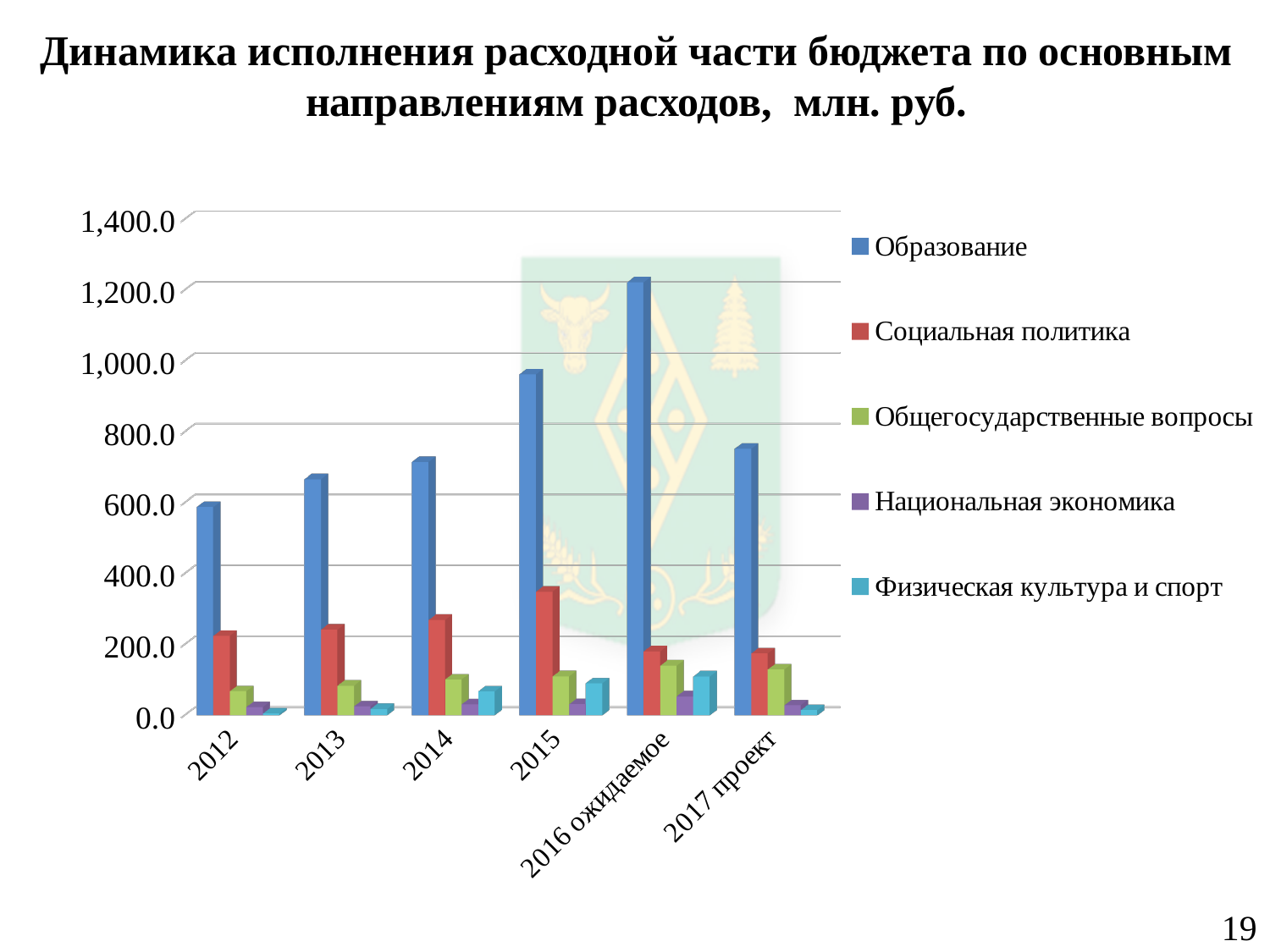
In which year is the value for Социальная политика highest? 2015 In which year is the value for Образование lowest? 2012 How many year categories are shown on the x axis? 6 Is the value for Социальная политика in 2015 greater or less than 400.0? less What kind of chart is shown on the slide? bar chart In which year is the value for Образование highest? 2016 ожидаемое Is the value for Образование in 2016 ожидаемое greater or less than 1,000.0? greater How many series does the legend list? 5 Which is larger, the value for Образование in 2015 or in 2017 проект? 2015 Does the value for Образование rise or fall from 2012 to 2016 ожидаемое? rise Is the value for Образование in 2015 greater or less than 800.0? greater In 2014, which is larger, Социальная политика or Общегосударственные вопросы? Социальная политика